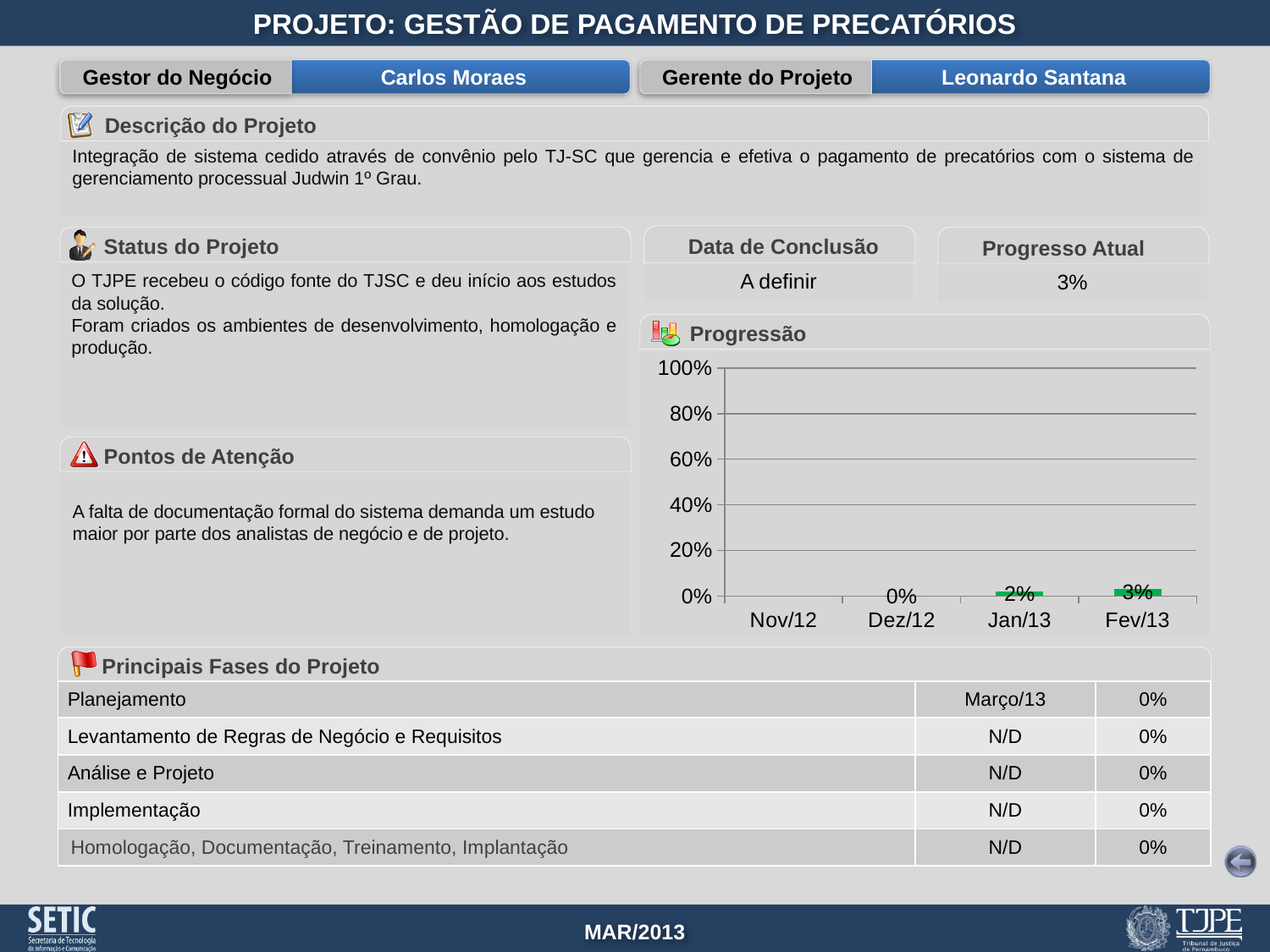
What is the highest value shown on the y axis of the Progressão chart? 100% In the Progressão chart, do the values rise or fall from Dez/12 to Fev/13? rise How many months are shown on the x axis of the Progressão chart? 4 In the Progressão chart, what is the value for Dez/12? 0% In the Progressão chart, is the value for Fev/13 greater or less than 20%? less In the Progressão chart, which is larger, the value for Jan/13 or the value for Fev/13? Fev/13 What kind of chart is the Progressão chart? bar chart In the Progressão chart, what is the value for Jan/13? 2% In the Progressão chart, which month has the highest value? Fev/13 What is the title of the chart on the slide? Progressão In the Progressão chart, what is the value for Fev/13? 3% In the Progressão chart, what is the difference between the values for Fev/13 and Jan/13? 1%